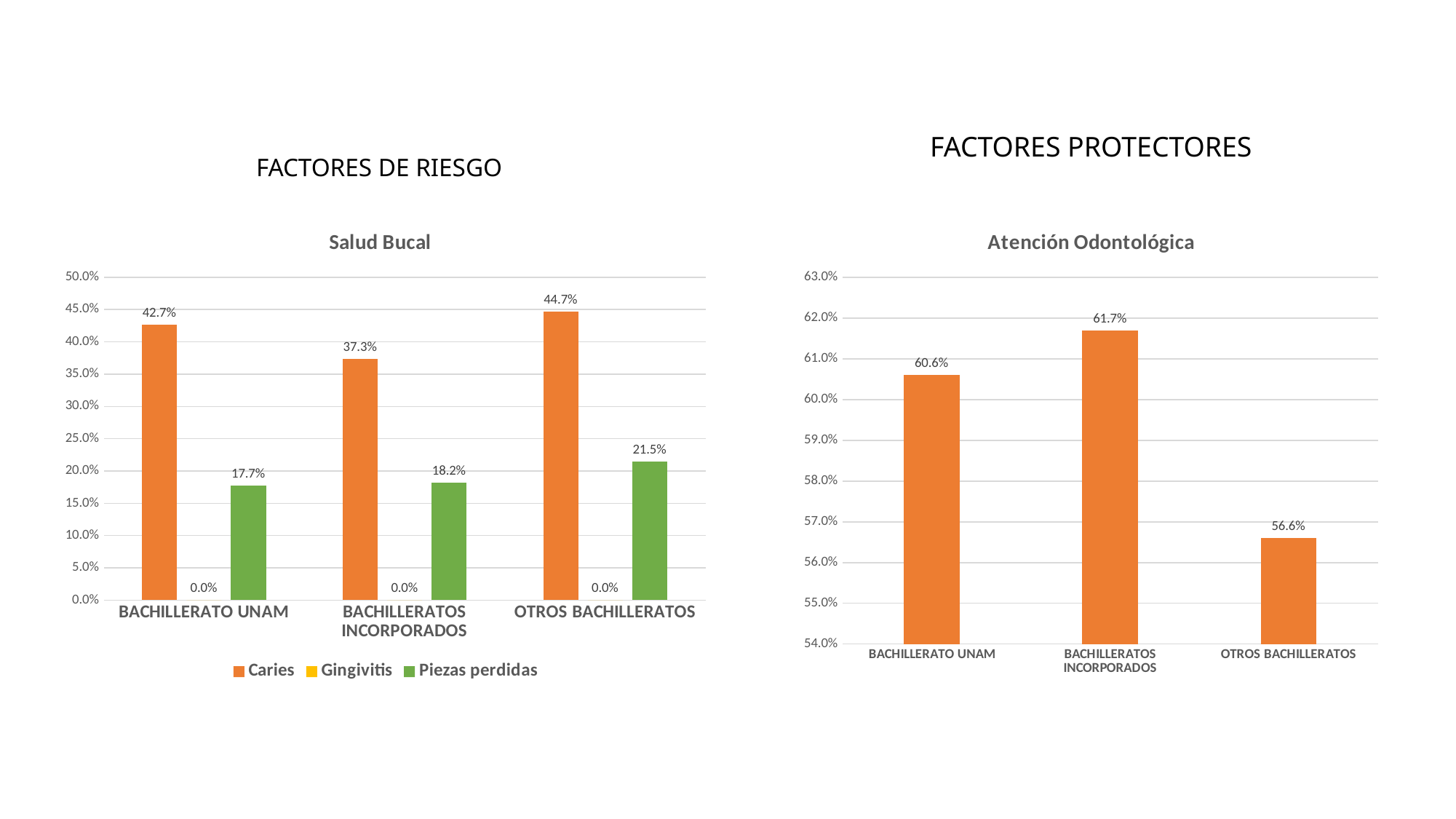
In the Salud Bucal chart, what is the difference between the Caries values for OTROS BACHILLERATOS and BACHILLERATOS INCORPORADOS? 7.4% In the Salud Bucal chart, which category has the highest Caries value? OTROS BACHILLERATOS What kind of chart is the Atención Odontológica chart? Bar chart In the Salud Bucal chart, how many series does the legend list? 3 In the Salud Bucal chart, what is the Caries value for BACHILLERATO UNAM? 42.7% In the Atención Odontológica chart, how many categories are shown? 3 In the Atención Odontológica chart, which category has the lowest value? OTROS BACHILLERATOS In the Salud Bucal chart, what is the Piezas perdidas value for OTROS BACHILLERATOS? 21.5% In the Salud Bucal chart, what is the Gingivitis value for BACHILLERATOS INCORPORADOS? 0.0% In the Atención Odontológica chart, what is the difference between BACHILLERATO UNAM and OTROS BACHILLERATOS? 4.0% In the Salud Bucal chart, which category has the lowest Piezas perdidas value? BACHILLERATO UNAM In the Atención Odontológica chart, what is the value for BACHILLERATOS INCORPORADOS? 61.7%